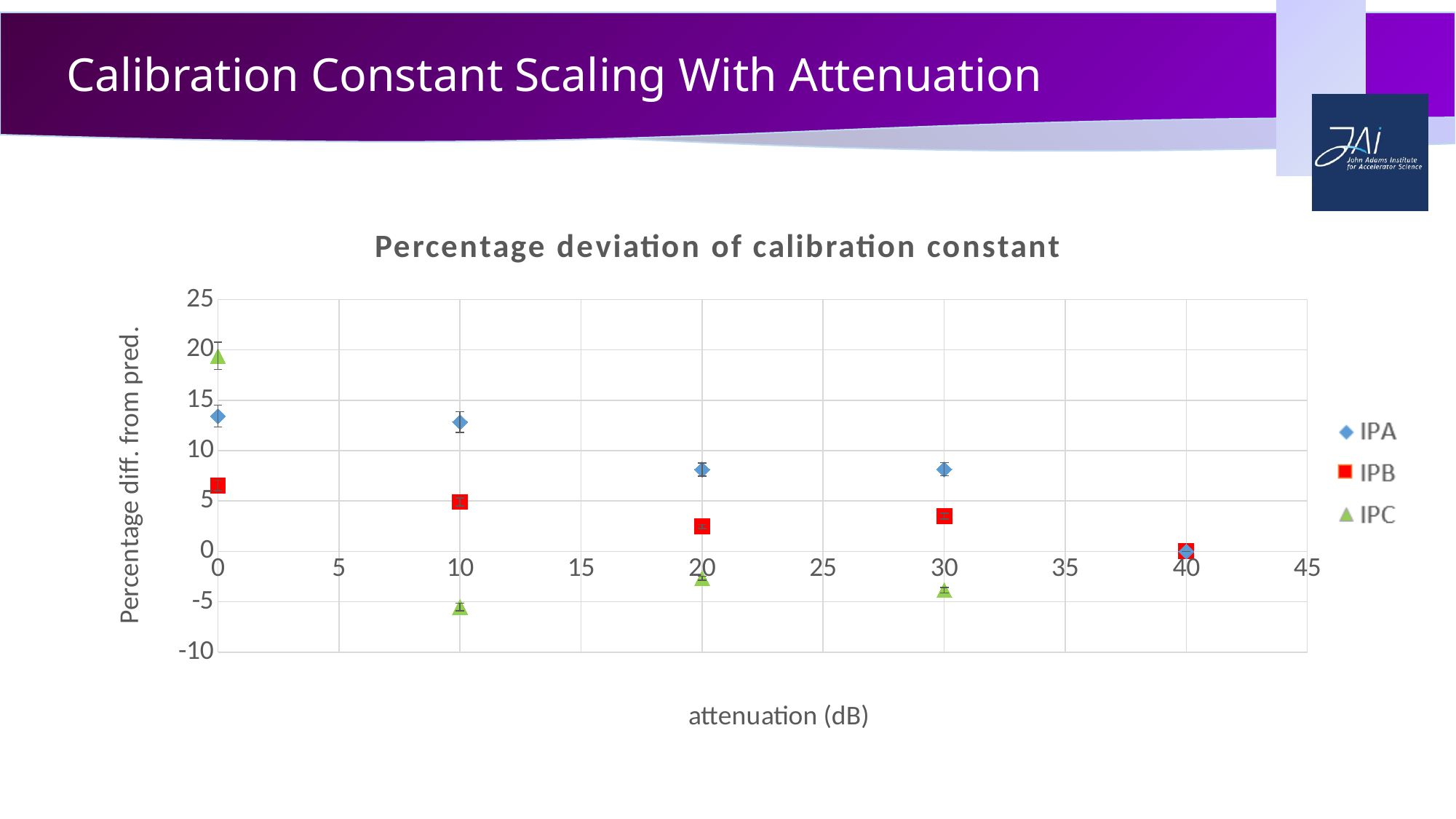
What is the title of the chart? Percentage deviation of calibration constant Is the IPC value at 0 dB attenuation greater or less than 15? greater How many series does the legend list? 3 Which series has the highest value at 0 dB attenuation? IPC Do the IPA values rise or fall as attenuation increases? fall At 10 dB attenuation, which is larger, the IPA value or the IPB value? IPA Which series has the lowest value at 10 dB attenuation? IPC What is the label of the x axis? attenuation (dB) Is the IPC value at 10 dB attenuation greater or less than 0? less Is the IPA value at 0 dB attenuation greater or less than 10? greater How many attenuation points are plotted for the IPA series? 5 What kind of chart is shown on the slide? scatter chart